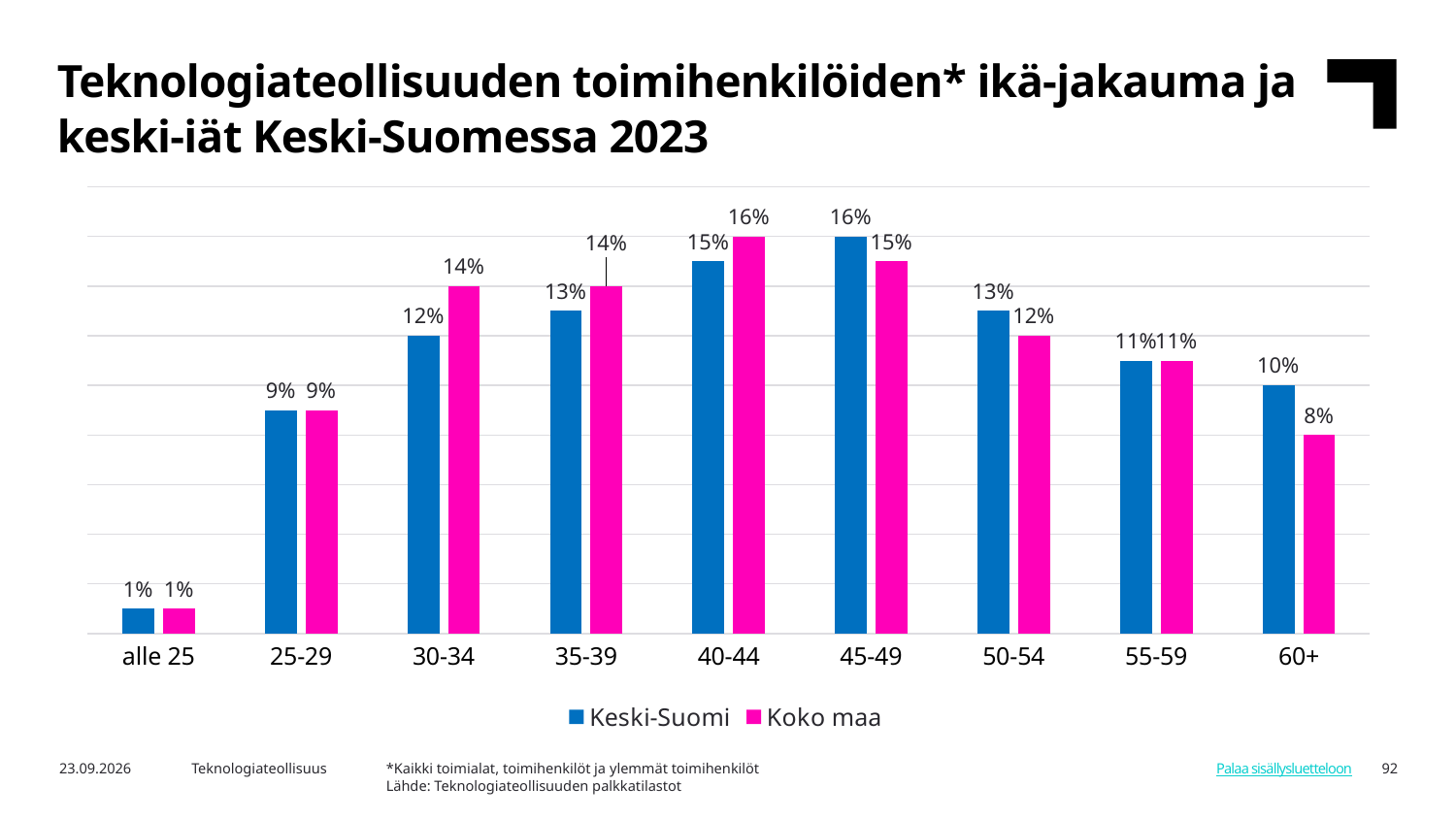
What is the difference between Keski-Suomi and Koko maa in the 30-34 age group? 2% How many age groups are shown on the x axis? 9 What is the difference between Keski-Suomi and Koko maa in the 60+ age group? 2% What kind of chart is shown on the slide? Bar chart Which age group has the lowest value for Koko maa? alle 25 What is the value for Keski-Suomi in the 45-49 age group? 16% Which age group has the highest value for Keski-Suomi? 45-49 What is the value for Koko maa in the 30-34 age group? 14% How many series does the legend list? 2 Which colour represents the Koko maa series? Pink What is the value for Koko maa in the 60+ age group? 8% In the 40-44 age group, which series has the larger value, Keski-Suomi or Koko maa? Koko maa